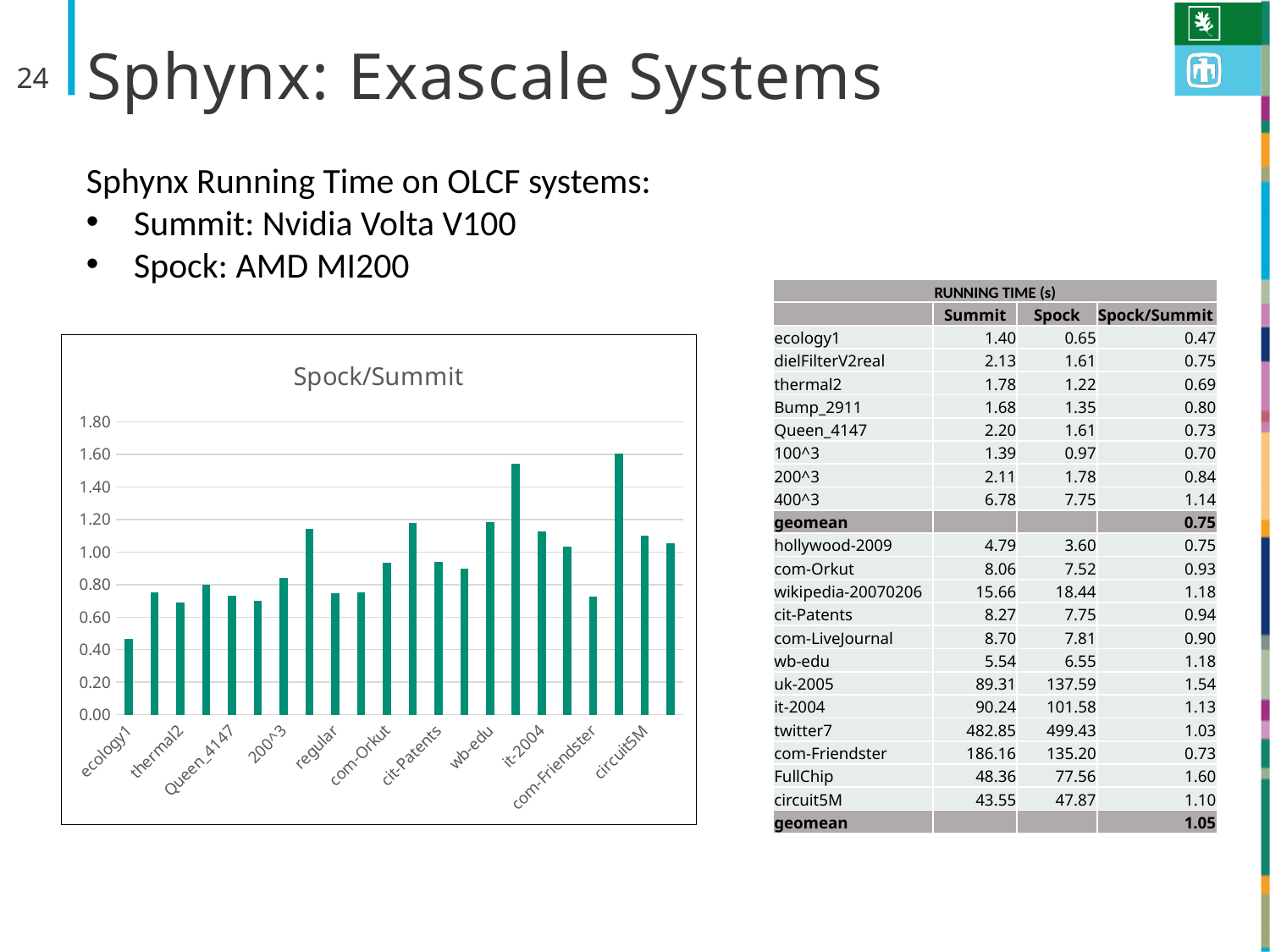
Is the value for ecology1 greater or less than 0.60? less Is the value for thermal2 greater or less than 0.80? less Is the value for it-2004 greater or less than 1.00? greater What is the title of the chart? Spock/Summit What is the highest tick value shown on the vertical axis of the chart? 1.80 What kind of chart is shown on the slide? bar chart Which is larger, the value for circuit5M or the value for ecology1? circuit5M Which labeled category has the lowest bar in the chart? ecology1 How many bars are plotted in the chart? 22